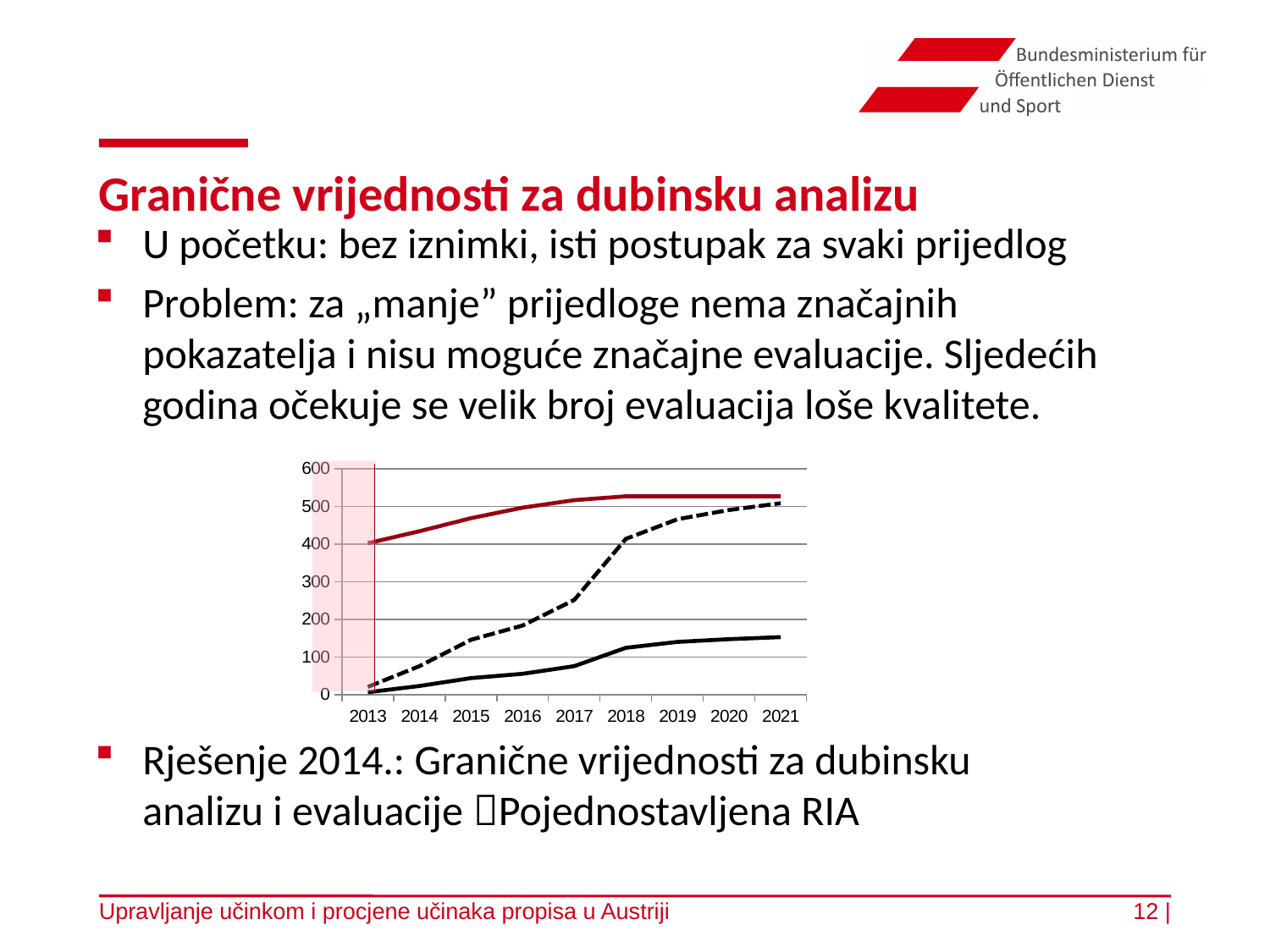
Is the value of the solid black line in 2021 greater or less than 200? less Do the values of the dashed line rise or fall from 2013 to 2021? rise What is the highest value shown on the y axis of the chart? 600 How many years are shown on the x axis of the chart? 9 Which line has the highest value in 2021: the red line, the dashed line, or the solid black line? the red line How many lines are plotted in the chart? 3 Is the value of the red line in 2021 greater or less than 500? greater What is the first year shown on the x axis of the chart? 2013 Do the values of the red line rise or fall from 2013 to 2021? rise Which line has the lowest value in 2021: the red line, the dashed line, or the solid black line? the solid black line What kind of chart is shown on the slide? line chart Is the value of the dashed line in 2017 greater or less than 200? greater